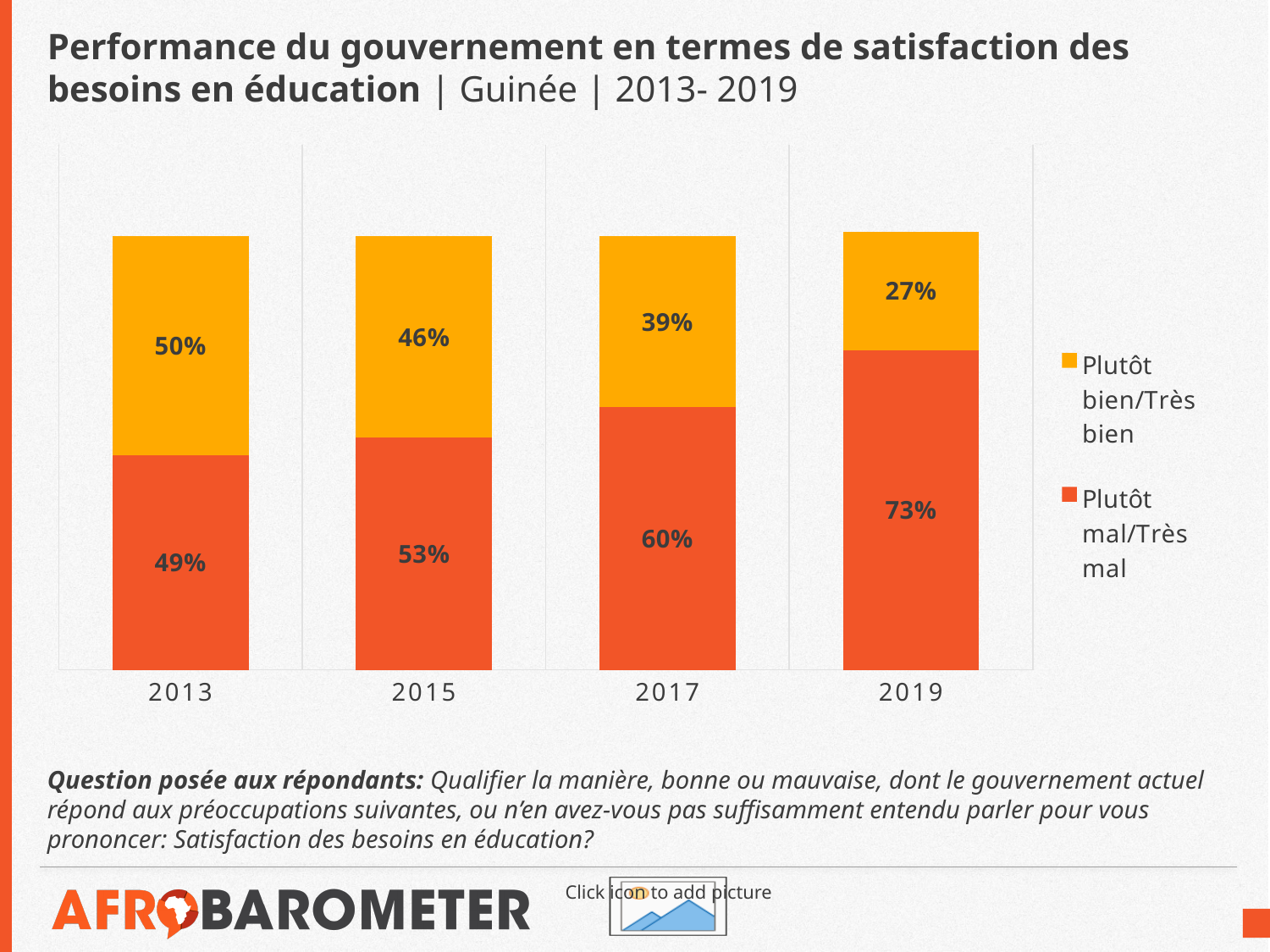
In which year is "Plutôt mal/Très mal" highest? 2019 What is the value for "Plutôt bien/Très bien" in 2017? 39% What is the value for "Plutôt mal/Très mal" in 2019? 73% What kind of chart is shown? Stacked bar chart Which is larger in 2015: "Plutôt bien/Très bien" or "Plutôt mal/Très mal"? Plutôt mal/Très mal What is the value for "Plutôt bien/Très bien" in 2013? 50% What is the difference between "Plutôt mal/Très mal" in 2019 and in 2013? 24 percentage points How many years are shown on the x axis? 4 How many series does the legend list? 2 In which year is "Plutôt bien/Très bien" lowest? 2019 What is the total of the stacked bar for 2017? 99% Does "Plutôt bien/Très bien" rise or fall from 2013 to 2019? Fall